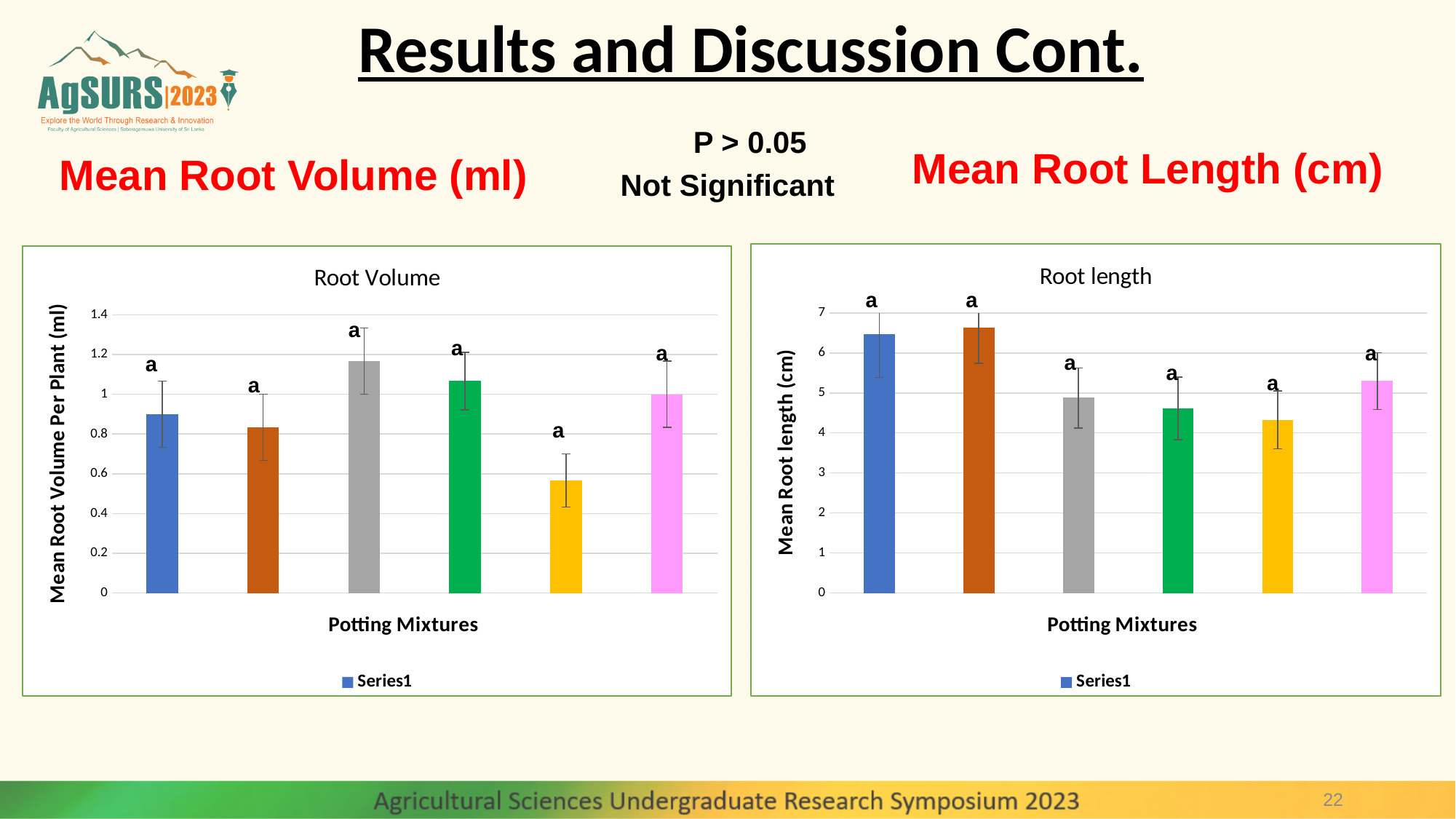
How many series does the legend of the Root length chart list? 1 How many bars are plotted in the Root Volume chart? 6 In the Root Volume chart, which bar is the highest? the grey (third) bar In the Root Volume chart, which bar is the lowest? the yellow (fifth) bar What is the x-axis label of the Root Volume chart? Potting Mixtures In the Root Volume chart, is the value for the grey (third) bar greater or less than 1? greater What kind of chart is the Root Volume chart on the left? bar chart In the Root Volume chart, is the value for the yellow (fifth) bar greater or less than 0.8? less In the Root length chart, is the value for the blue (first) bar greater or less than 6? greater What is the y-axis label of the Root length chart? Mean Root length (cm) In the Root length chart, which is larger, the blue (first) bar or the grey (third) bar? the blue (first) bar